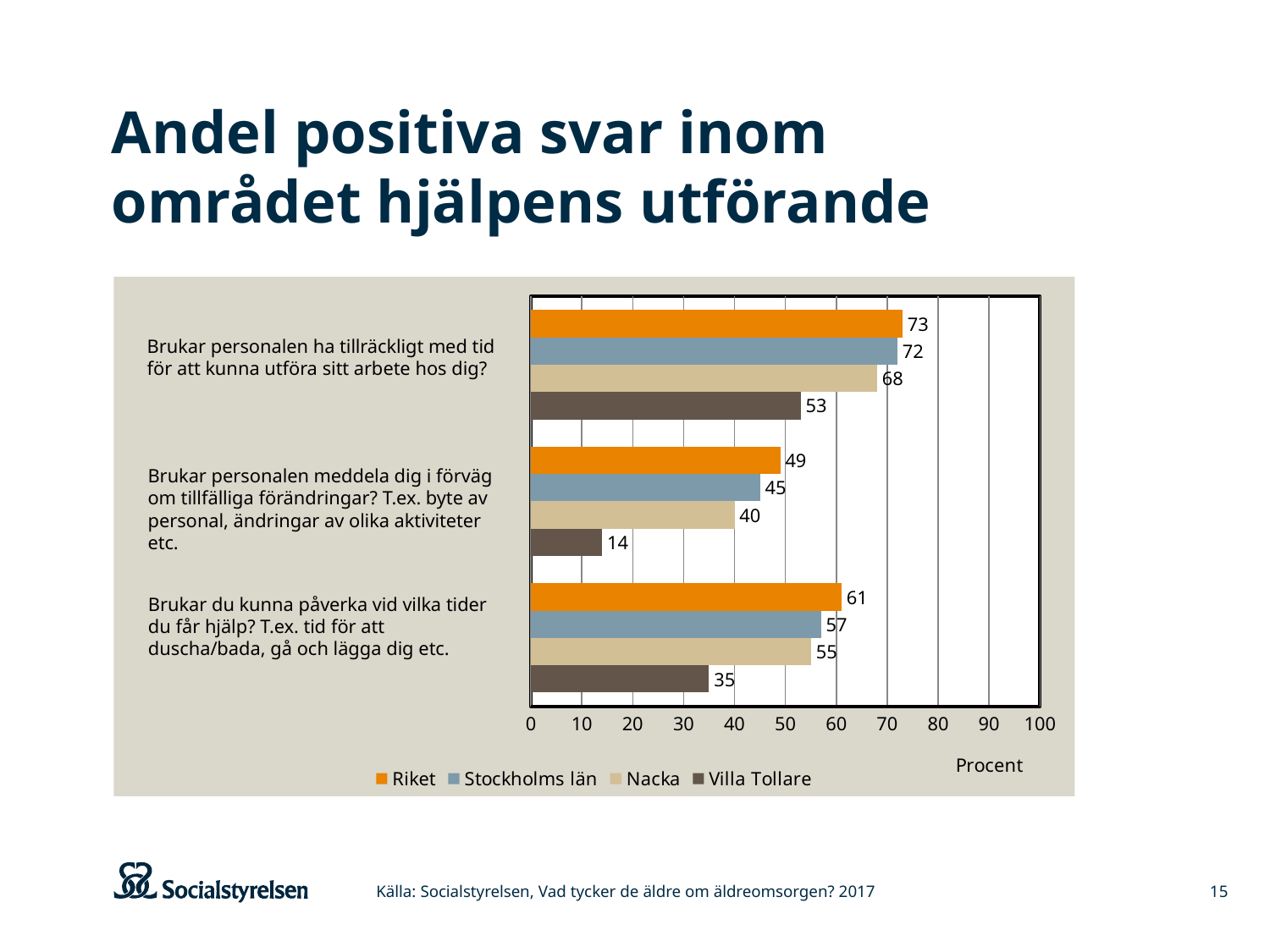
What is the value for Stockholms län on the question 'Brukar personalen meddela dig i förväg om tillfälliga förändringar?' 45 How many series does the legend list? 4 Which series has the highest value on the question 'Brukar personalen ha tillräckligt med tid för att kunna utföra sitt arbete hos dig?' Riket What is the value for Riket on the question 'Brukar personalen ha tillräckligt med tid för att kunna utföra sitt arbete hos dig?' 73 What is the value for Villa Tollare on the question 'Brukar personalen meddela dig i förväg om tillfälliga förändringar?' 14 Which series has the lowest value on the question 'Brukar du kunna påverka vid vilka tider du får hjälp?' Villa Tollare What unit is shown on the x axis of the chart? Procent Which is larger: Nacka on 'Brukar personalen ha tillräckligt med tid...' or Nacka on 'Brukar du kunna påverka vid vilka tider du får hjälp?' Nacka on 'Brukar personalen ha tillräckligt med tid...' (68) How many questions (categories) are shown on the chart? 3 What is the difference between Riket and Villa Tollare on the question 'Brukar personalen meddela dig i förväg om tillfälliga förändringar?' 35 What is the value for Nacka on the question 'Brukar du kunna påverka vid vilka tider du får hjälp?' 55 What kind of chart is shown on the slide? Bar chart